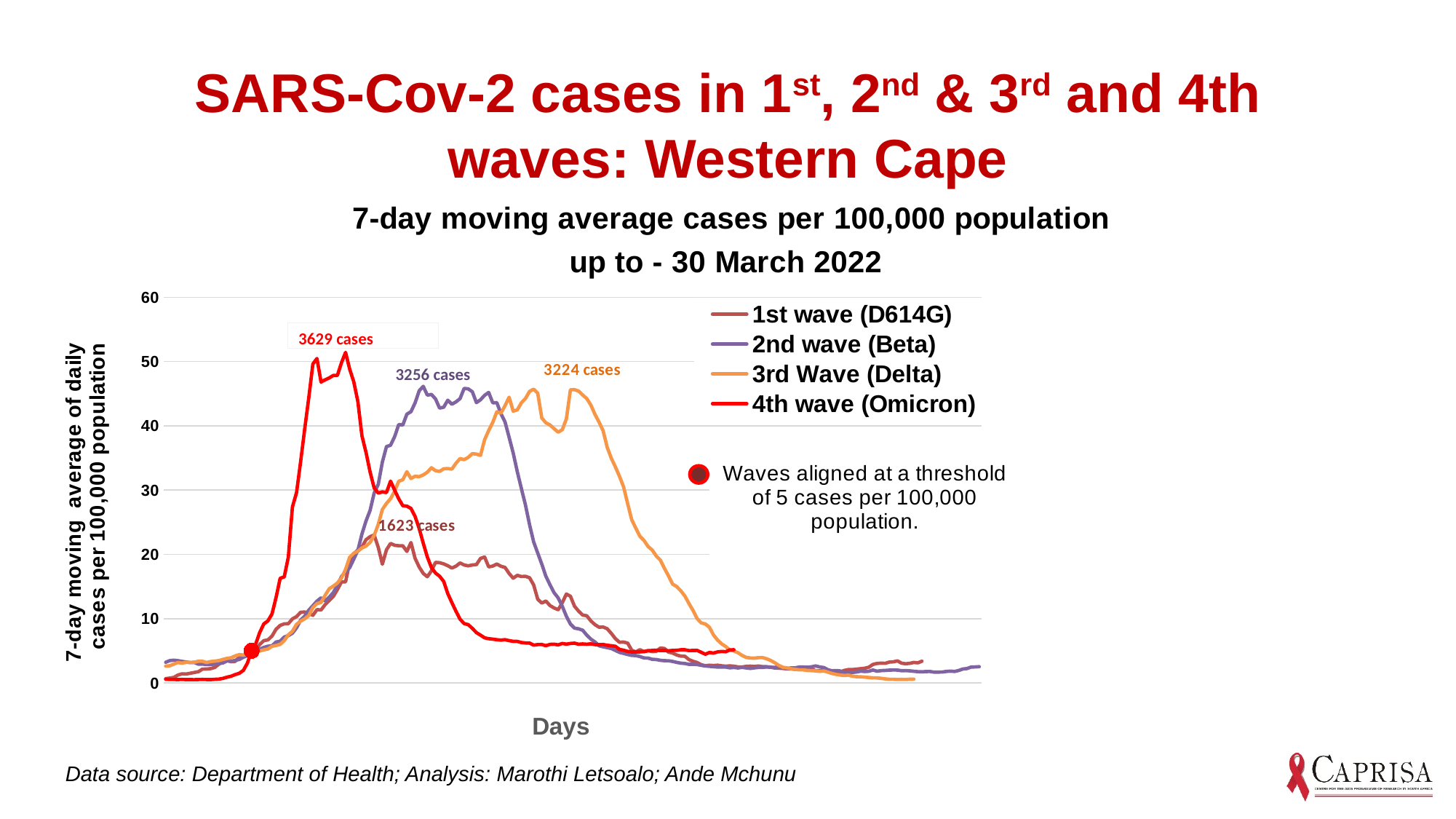
What is the label on the x axis? Days Which wave has the highest annotated number of cases? 4th wave (Omicron) Which wave has the lowest annotated number of cases? 1st wave (D614G) What is the chart's title? 7-day moving average cases per 100,000 population up to - 30 March 2022 How many cases are annotated for the 4th wave (Omicron)? 3629 cases Is the peak 7-day moving average for the 1st wave (D614G) greater or less than 30? less What kind of chart is shown on the slide? line chart How many cases are annotated for the 3rd Wave (Delta)? 3224 cases How many cases are annotated for the 2nd wave (Beta)? 3256 cases How many cases are annotated for the 1st wave (D614G)? 1623 cases How many series does the legend list? 4 What is the difference between the annotated cases for the 4th wave (Omicron) and the 1st wave (D614G)? 2006 cases